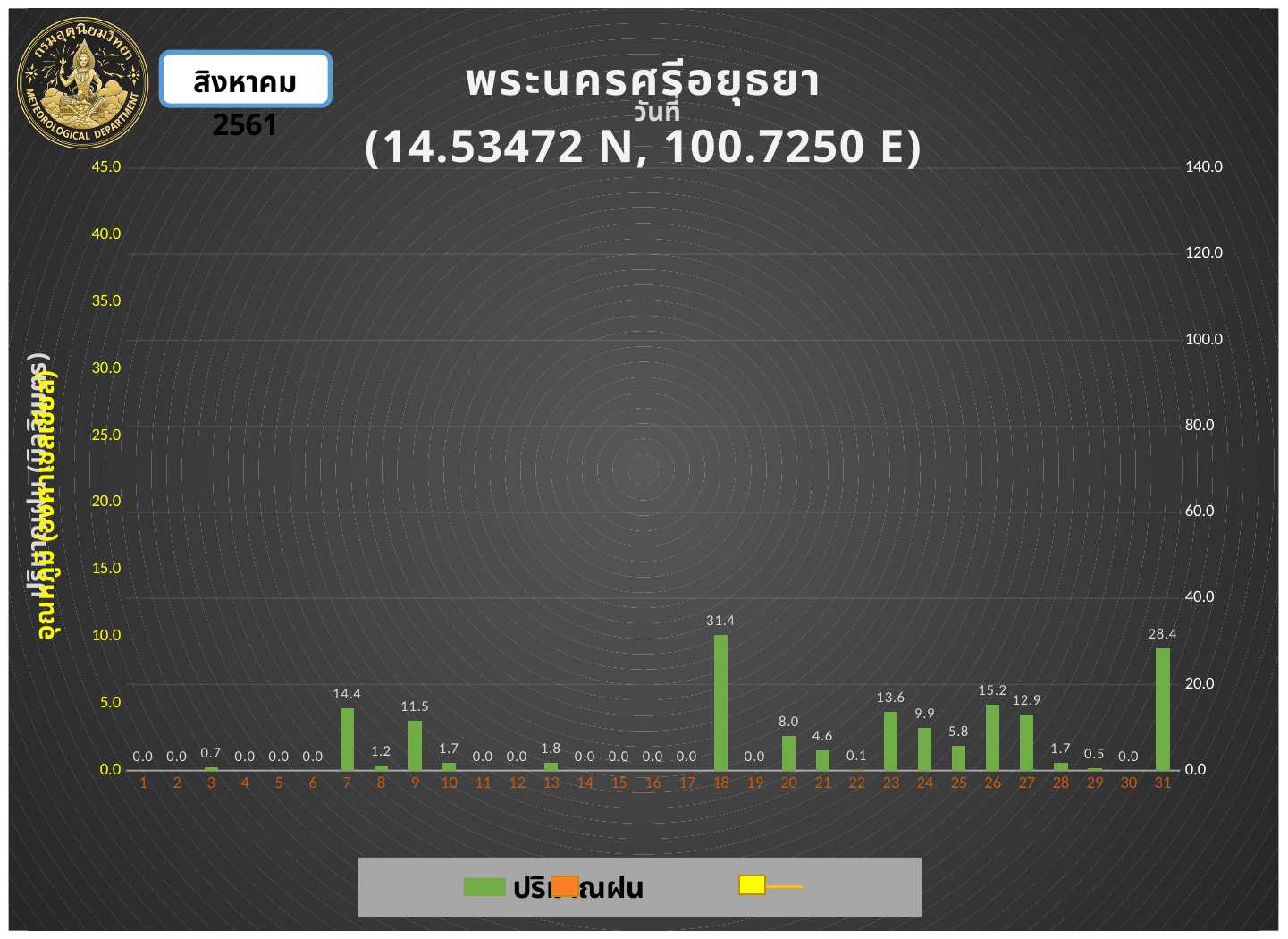
Which has a larger rainfall value, day 20 or day 24? day 24 What is the rainfall value shown for day 31? 28.4 What coordinates are given in the chart title? 14.53472 N, 100.7250 E What is the rainfall value shown for day 22? 0.1 What kind of chart is shown on the slide? bar chart How many days are shown on the x axis? 31 What is the difference between the rainfall values for day 18 and day 31? 3.0 What is the difference between the rainfall values for day 26 and day 27? 2.3 Which day has the highest rainfall value? 18 What is the rainfall value shown for day 7? 14.4 What is the rainfall value shown for day 18? 31.4 Which has a larger rainfall value, day 9 or day 23? day 23